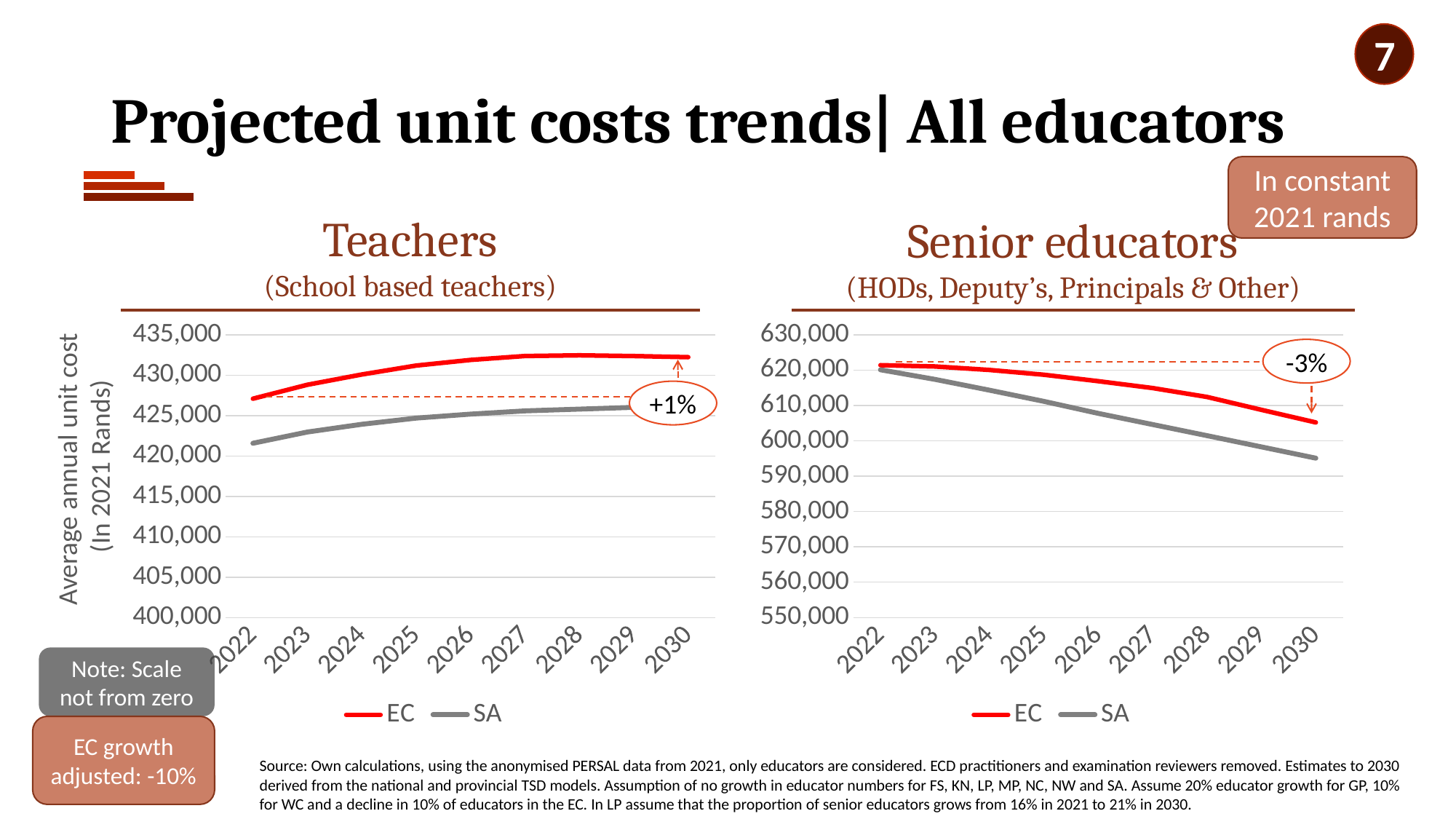
In the Teachers chart, is the SA value for 2022 greater or less than 425,000? less In the Teachers chart, which series has the higher value in 2030, EC or SA? EC In the Teachers chart, does the EC line rise or fall from 2022 to 2030? rise How many years are plotted along the x axis of the Teachers chart? 9 What kind of chart is the Teachers chart? line chart In the Senior educators chart, is the EC value for 2030 greater or less than 600,000? greater In the Teachers chart, is the EC value for 2030 greater or less than 430,000? greater In the Senior educators chart, which series has the lower value in 2030, EC or SA? SA How many series does the legend of the Senior educators chart list? 2 What percentage change is annotated on the Senior educators chart? -3% In the Senior educators chart, does the SA line rise or fall from 2022 to 2030? fall